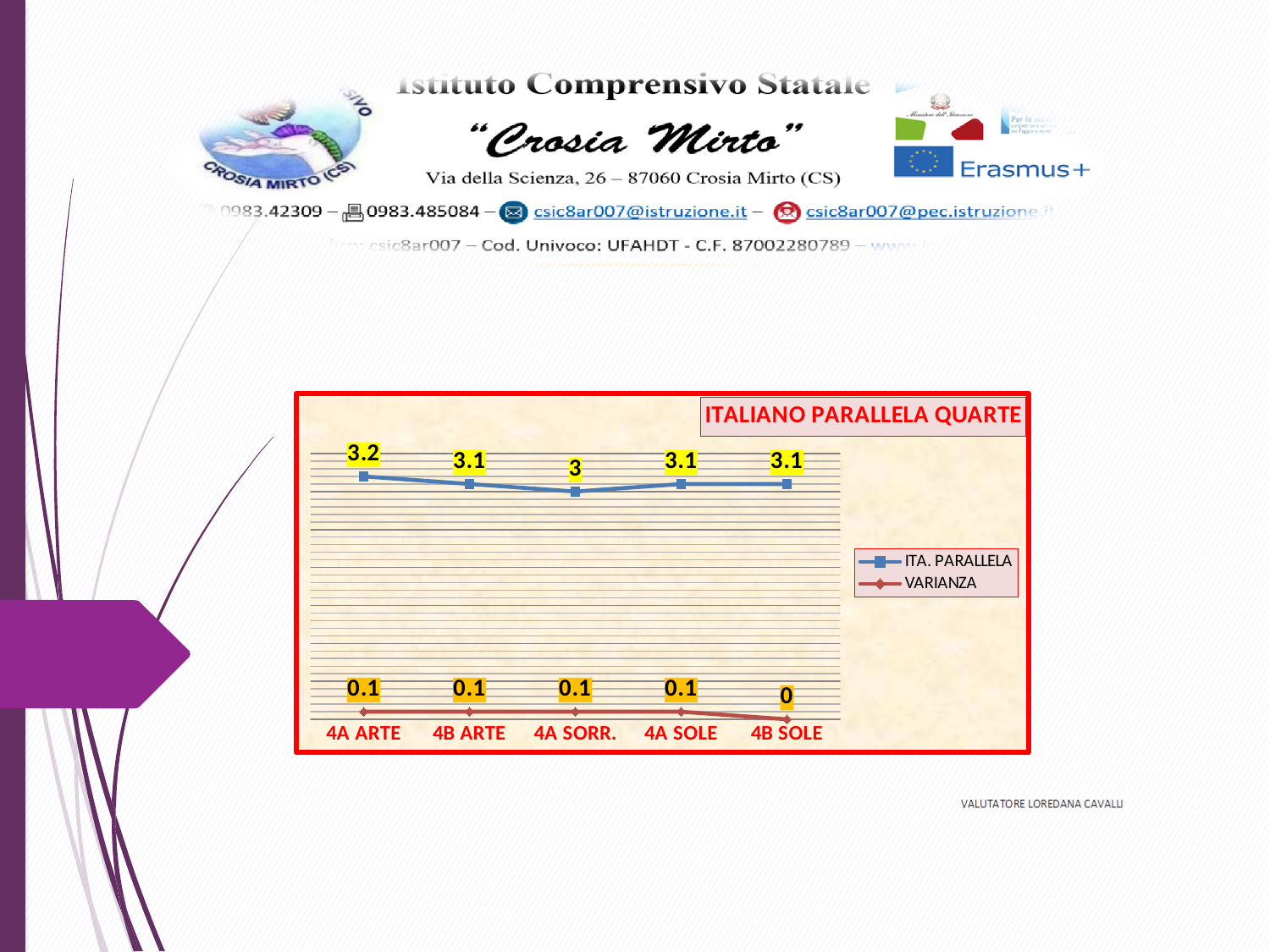
Which category has the lowest VARIANZA value? 4B SOLE What is the difference between the ITA. PARALLELA values for 4A ARTE and 4A SORR.? 0.2 What is the VARIANZA value for 4B SOLE? 0 How many categories are shown on the x axis? 5 How many series does the legend list? 2 Which is larger, the ITA. PARALLELA value for 4A ARTE or for 4B ARTE? 4A ARTE What type of chart is shown? Line chart What is the ITA. PARALLELA value for 4A SORR.? 3 Which category has the highest ITA. PARALLELA value? 4A ARTE Which category has the lowest ITA. PARALLELA value? 4A SORR. What is the VARIANZA value for 4A SOLE? 0.1 What is the ITA. PARALLELA value for 4A ARTE? 3.2